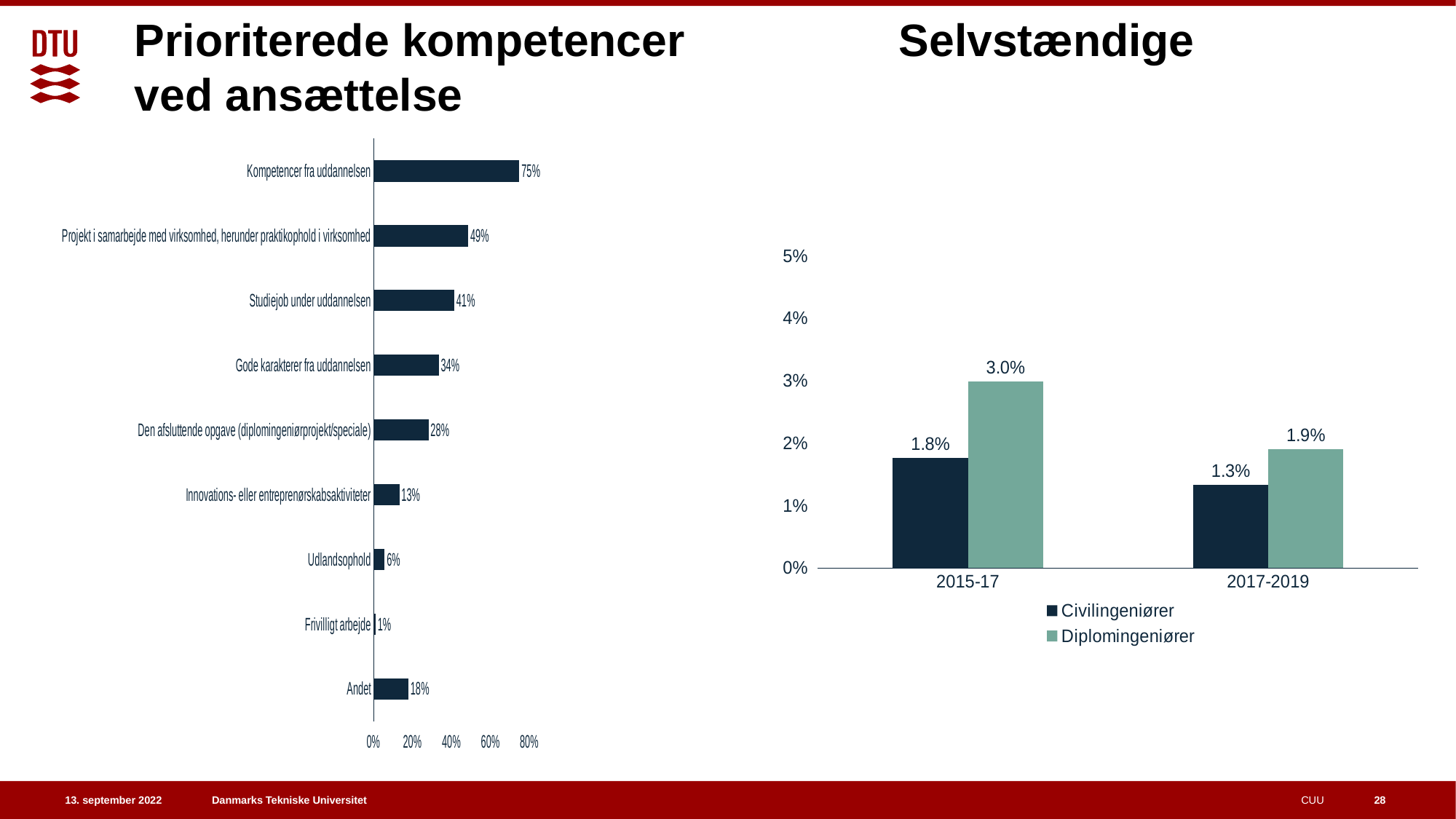
In the 'Prioriterede kompetencer ved ansættelse' chart, what is the value for 'Studiejob under uddannelsen'? 41% In the 'Selvstændige' chart, what is the difference between Diplomingeniører and Civilingeniører in 2017-2019? 0.6% In the 'Prioriterede kompetencer ved ansættelse' chart, which is larger: 'Andet' or 'Innovations- eller entreprenørskabsaktiviteter'? Andet In the 'Prioriterede kompetencer ved ansættelse' chart, what is the difference between 'Gode karakterer fra uddannelsen' and 'Udlandsophold'? 28% In the 'Prioriterede kompetencer ved ansættelse' chart, what is the value for 'Kompetencer fra uddannelsen'? 75% In the 'Prioriterede kompetencer ved ansættelse' chart, which category has the lowest value? Frivilligt arbejde In the 'Selvstændige' chart, do the Civilingeniører values rise or fall from 2015-17 to 2017-2019? Fall In the 'Selvstændige' chart, what is the value for Diplomingeniører in 2015-17? 3.0% In the 'Prioriterede kompetencer ved ansættelse' chart, how many categories are shown? 9 In the 'Selvstændige' chart, how many series does the legend list? 2 What kind of chart is the 'Selvstændige' chart? Bar chart In the 'Prioriterede kompetencer ved ansættelse' chart, which category has the highest value? Kompetencer fra uddannelsen